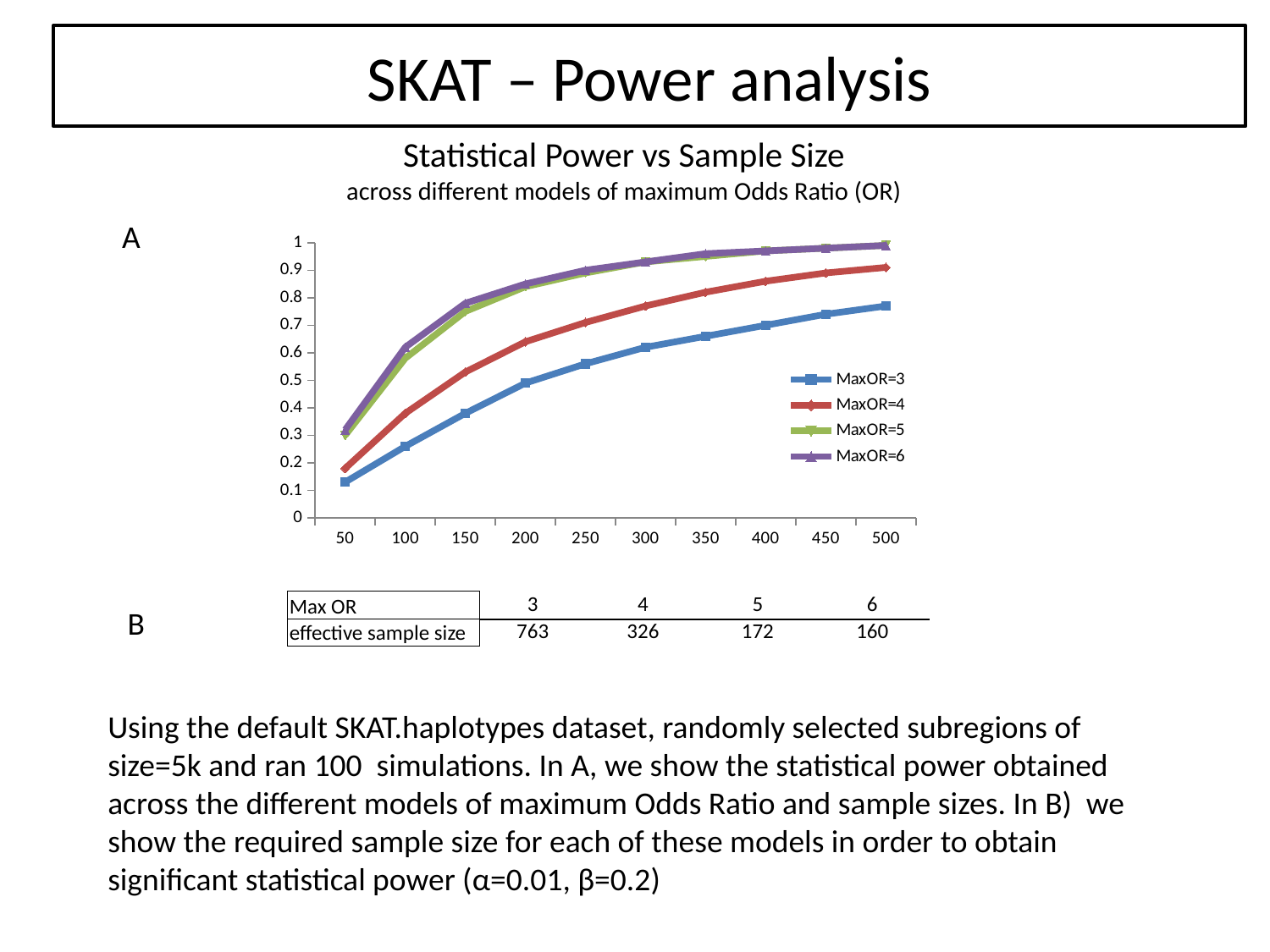
In the chart in panel A, is the value for MaxOR=4 at sample size 50 greater or less than 0.3? less In the chart in panel A, does statistical power rise or fall as sample size increases? rise What kind of chart is shown in panel A? line chart In the chart in panel A, which series has the lowest value at sample size 300? MaxOR=3 How many sample size values are shown on the x axis of the chart in panel A? 10 In the chart in panel A, is the value for MaxOR=3 at sample size 50 greater or less than 0.2? less What is the title of the chart in panel A? Statistical Power vs Sample Size across different models of maximum Odds Ratio (OR) In the chart in panel A, is the value for MaxOR=3 at sample size 500 greater or less than 0.9? less How many series does the legend of the chart in panel A list? 4 In the chart in panel A, at sample size 100, which series has the larger value: MaxOR=4 or MaxOR=6? MaxOR=6 In the chart in panel A, at sample size 200, which series has the larger value: MaxOR=3 or MaxOR=4? MaxOR=4